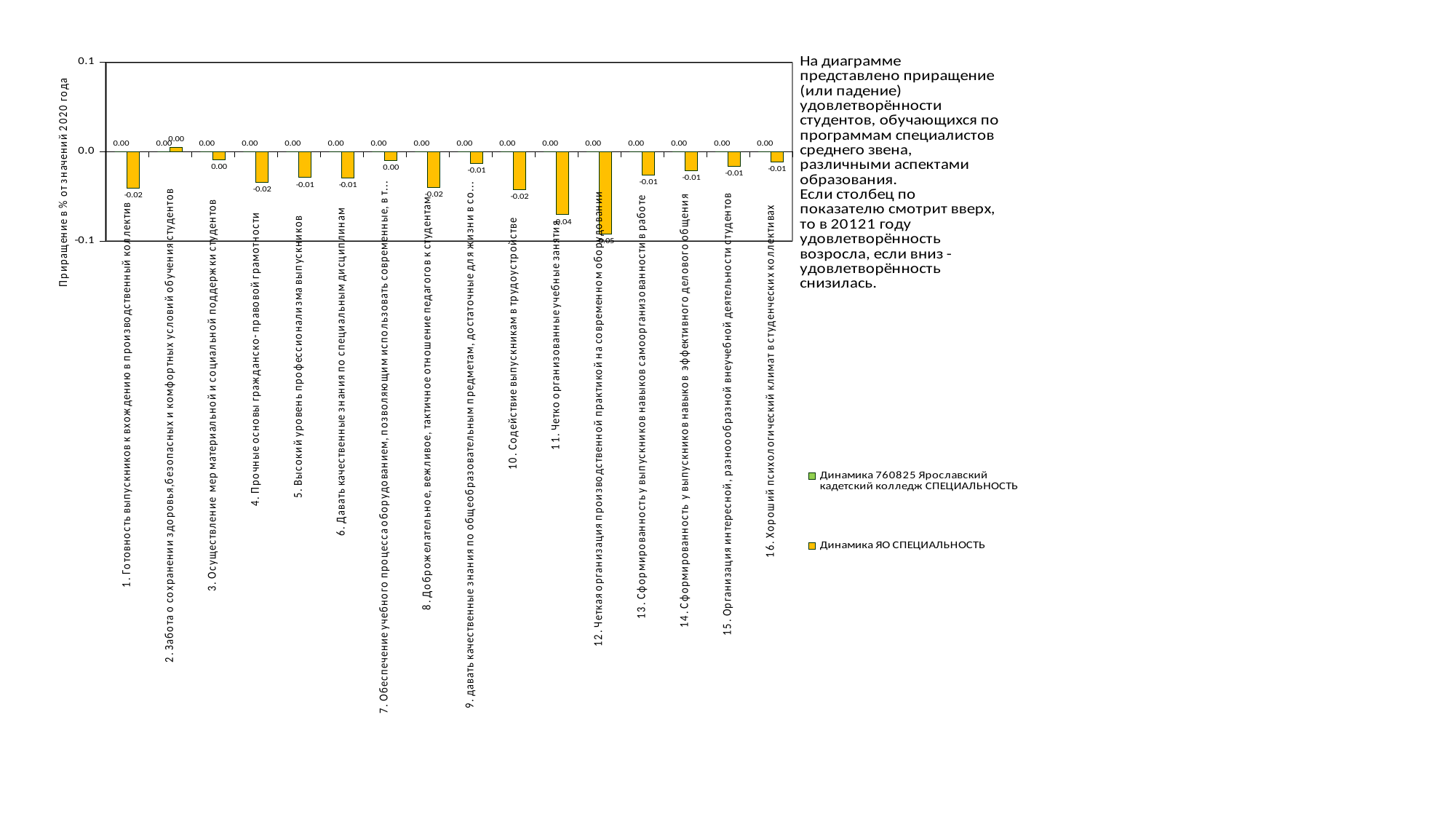
Is the 'Динамика ЯО СПЕЦИАЛЬНОСТЬ' value for category 12 greater or less than -0.1? greater What is the value of the 'Динамика ЯО СПЕЦИАЛЬНОСТЬ' series for category 1 (Готовность выпускников к вхождению в производственный коллектив)? -0.02 How many categories are plotted along the x axis? 16 What kind of chart is shown on the slide? bar chart How many series does the legend list? 2 What is the value of the 'Динамика ЯО СПЕЦИАЛЬНОСТЬ' series for category 12 (Четкая организация производственной практикой на современном оборудовании)? -0.05 What is the value of the 'Динамика 760825 Ярославский кадетский колледж СПЕЦИАЛЬНОСТЬ' series for category 5 (Высокий уровень профессионализма выпускников)? 0.00 In the 'Динамика ЯО СПЕЦИАЛЬНОСТЬ' series, which is larger: the value for category 10 (Содействие выпускникам в трудоустройстве) or category 11 (Четко организованные учебные занятия)? category 10 What is the title of the vertical axis? Приращение в % от значений 2020 года What is the value of the 'Динамика ЯО СПЕЦИАЛЬНОСТЬ' series for category 11 (Четко организованные учебные занятия)? -0.04 What is the difference between the 'Динамика ЯО СПЕЦИАЛЬНОСТЬ' values for category 11 and category 12? 0.01 Which category has the lowest value in the 'Динамика ЯО СПЕЦИАЛЬНОСТЬ' series? 12. Четкая организация производственной практикой на современном оборудовании